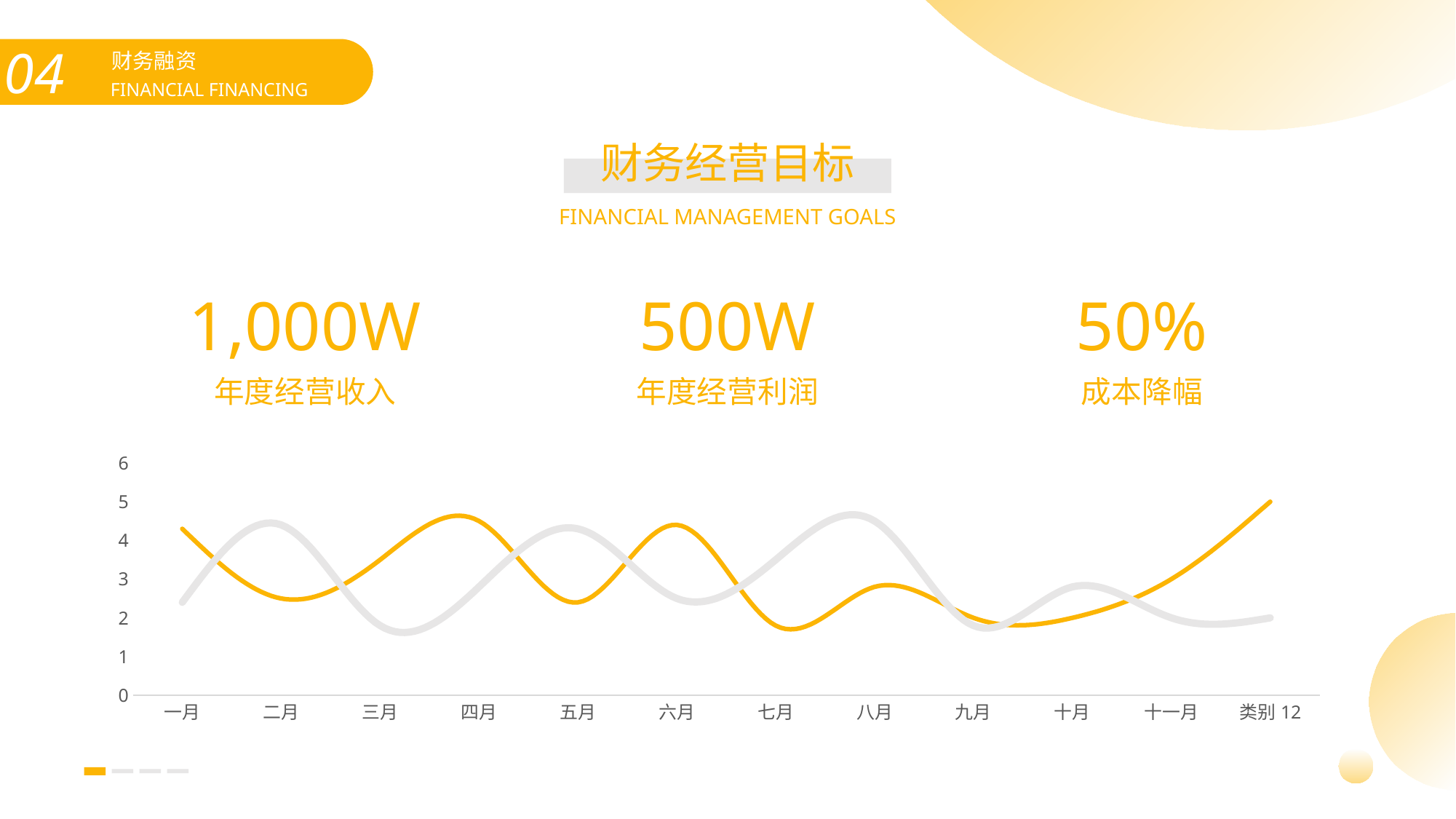
Is the value of the orange line at 类别 12 greater or less than 4? greater How many lines are plotted in the chart? 2 Is the value of the orange line at 七月 greater or less than 3? less Does the orange line rise or fall from 九月 to 类别 12? rise What kind of chart is shown at the bottom of the slide? line chart Is the value of the grey line at 八月 greater or less than 4? greater What is the label of the last category on the x axis of the chart? 类别 12 How many categories are shown on the x axis of the chart? 12 At 二月, which line is higher, the orange line or the grey line? grey line At 四月, which line is higher, the orange line or the grey line? orange line